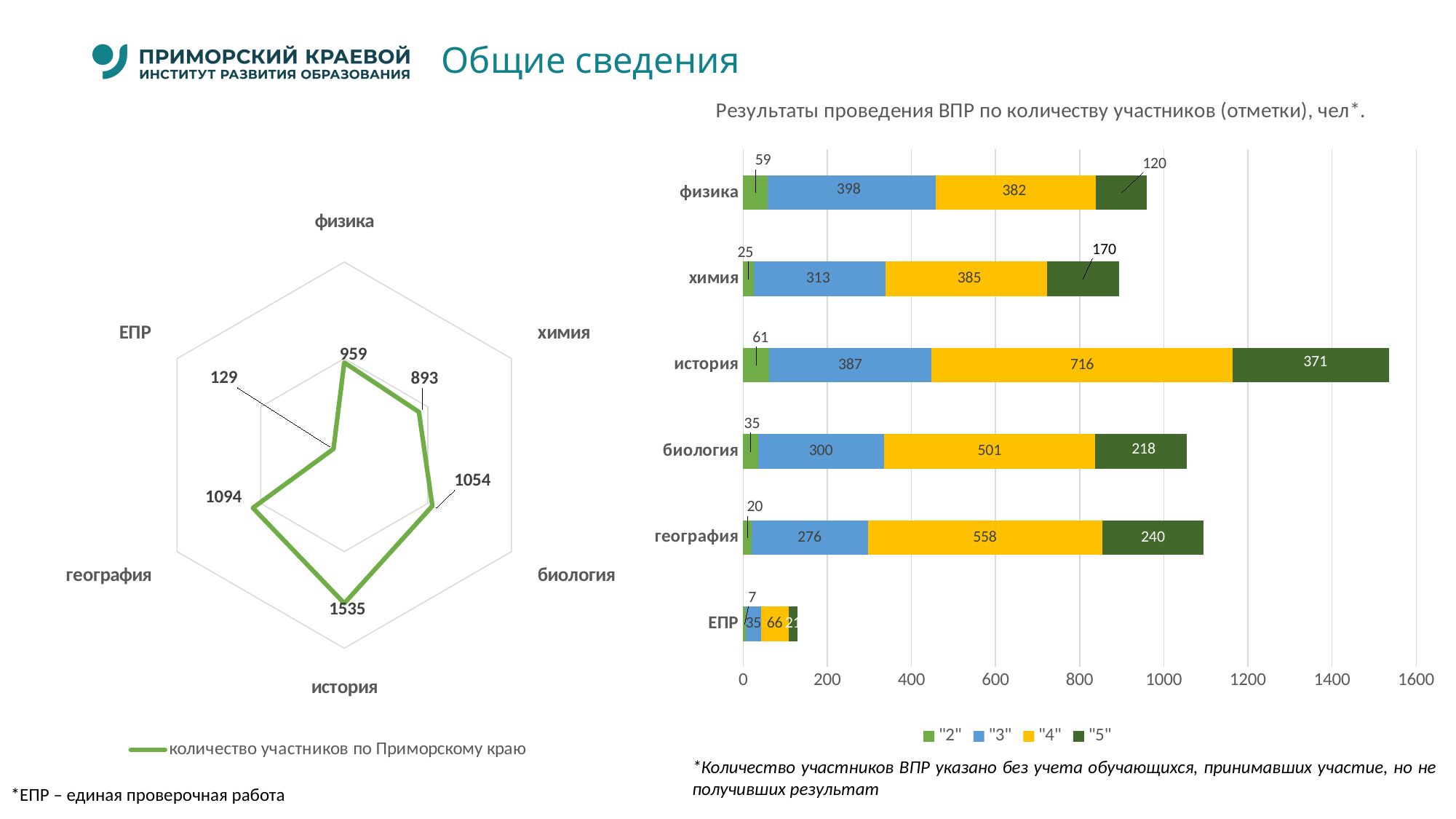
On the right chart 'Результаты проведения ВПР по количеству участников (отметки), чел*.', what is the total of the stacked bar for биология? 1054 On the left radar chart, what is the difference between the values for география and химия? 201 On the right chart 'Результаты проведения ВПР по количеству участников (отметки), чел*.', what kind of chart is it? stacked bar chart On the left radar chart, which subject has the highest number of participants? история On the left radar chart, which subject has the lowest number of participants? ЕПР On the right chart 'Результаты проведения ВПР по количеству участников (отметки), чел*.', what is the value of the "4" series for история? 716 On the left radar chart, what is the number of participants for история? 1535 On the right chart 'Результаты проведения ВПР по количеству участников (отметки), чел*.', which is larger: the "5" value for география or the "5" value for биология? география On the right chart 'Результаты проведения ВПР по количеству участников (отметки), чел*.', how many series does the legend list? 4 On the right chart 'Результаты проведения ВПР по количеству участников (отметки), чел*.', what is the difference between the "3" values for физика and химия? 85 On the left radar chart, how many categories are plotted? 6 On the right chart 'Результаты проведения ВПР по количеству участников (отметки), чел*.', what is the value of the "2" series for физика? 59